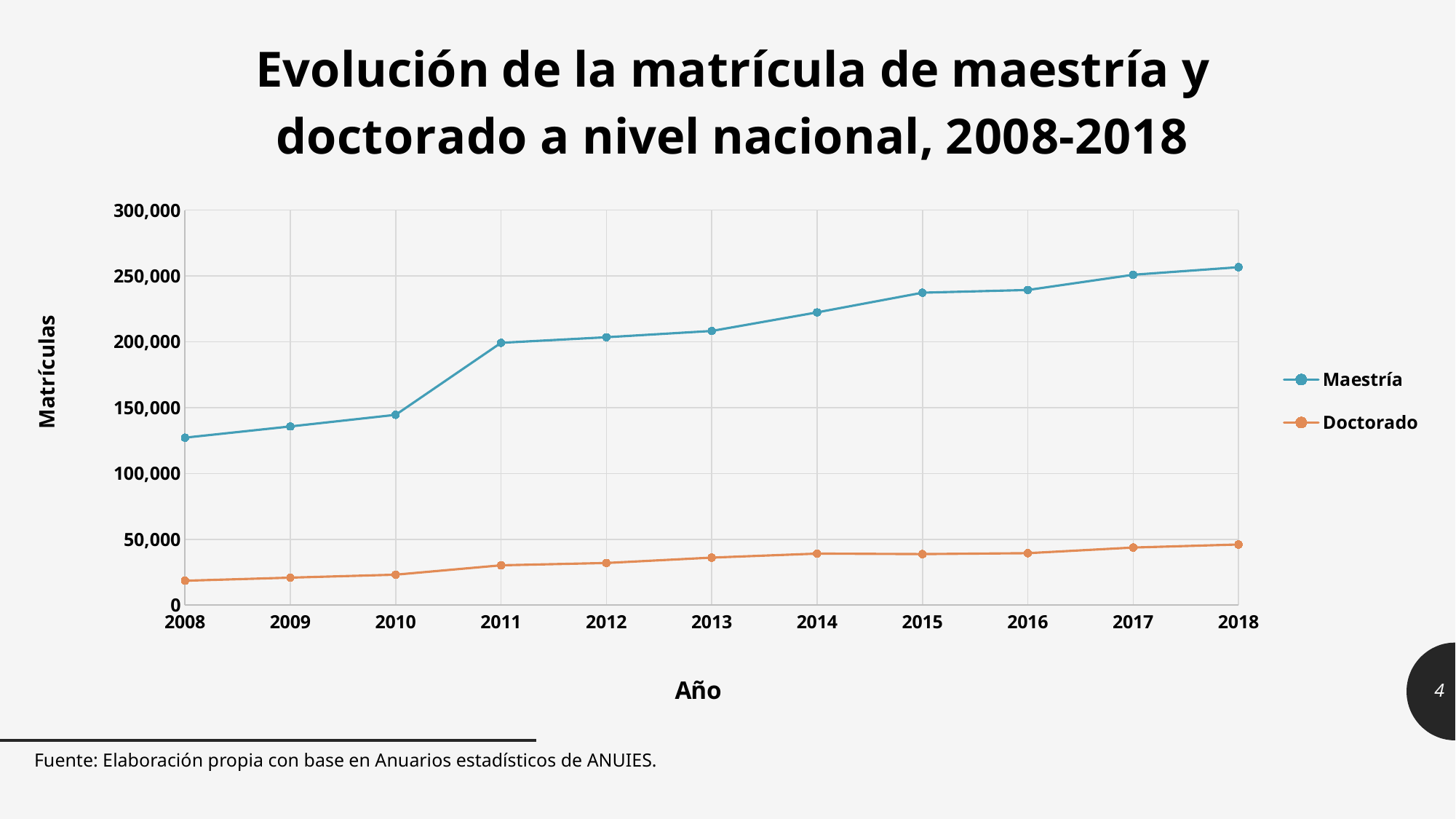
Which series has the higher values throughout the chart, Maestría or Doctorado? Maestría How many years are plotted along the x axis? 11 What is the label of the y axis? Matrículas In which year is the Maestría value lowest? 2008 What kind of chart is shown on the slide? line chart Is the Maestría value for 2010 greater or less than 150,000? less Does the Maestría series generally rise or fall from 2008 to 2018? rise Is the Maestría value for 2018 greater or less than 250,000? greater In which year is the Maestría value highest? 2018 Is the Doctorado value for 2018 greater or less than 50,000? less In which year is the Doctorado value lowest? 2008 How many series does the legend list? 2